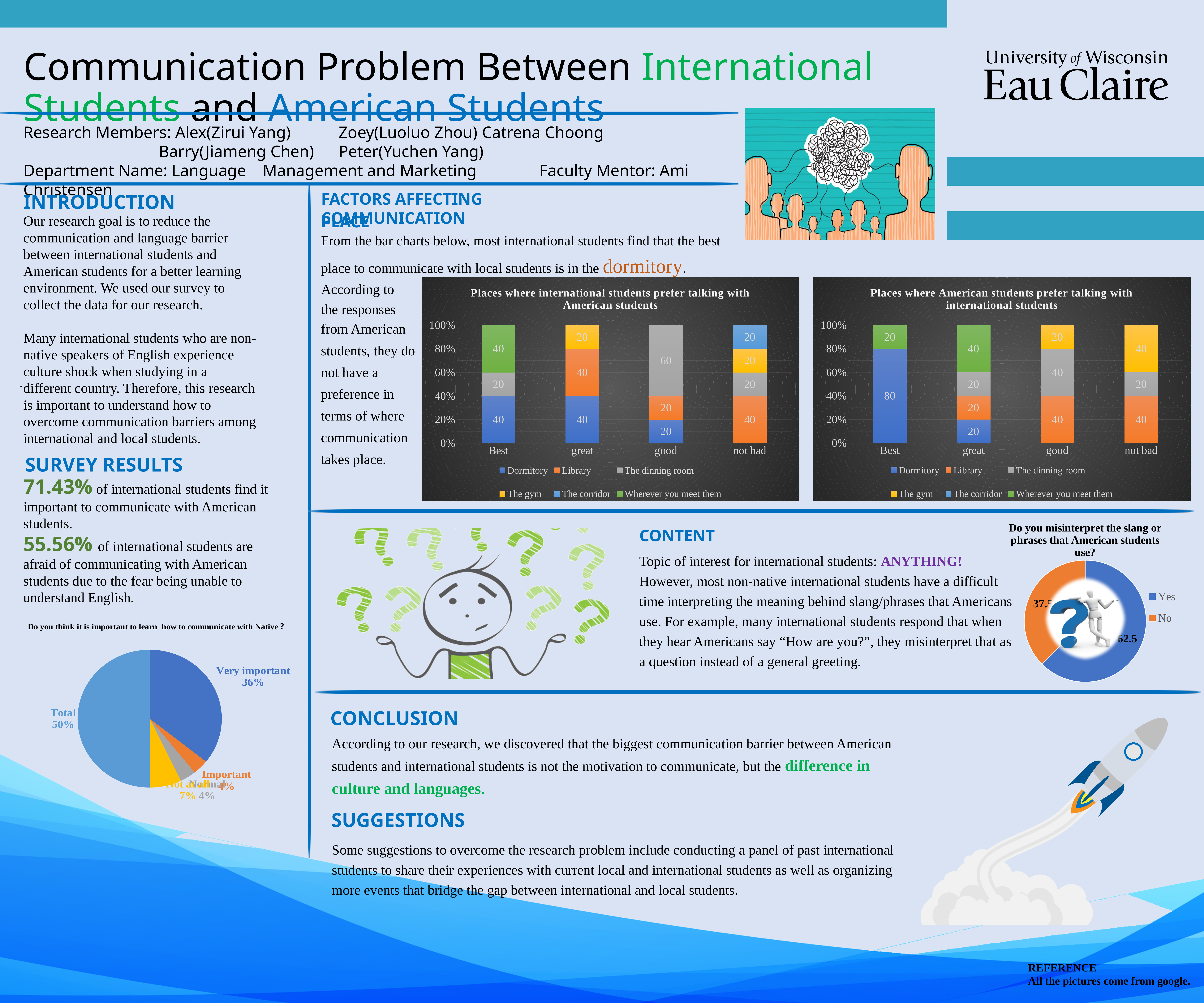
In the pie chart 'Do you think it is important to learn how to communicate with Native?', what share is labelled 'Very important'? 36% In the chart 'Places where international students prefer talking with American students', what is the value for Dormitory in the 'Best' category? 40 In the pie chart 'Do you misinterpret the slang or phrases that American students use?', what is the value for Yes? 62.5 In the chart 'Places where international students prefer talking with American students', what is the difference between The dinning room and Library in the 'good' category? 40 In the chart 'Places where American students prefer talking with international students', which is larger in the 'good' category: Library or The gym? Library In the chart 'Places where international students prefer talking with American students', what is the value for The dinning room in the 'good' category? 60 In the chart 'Places where American students prefer talking with international students', what is the value for Wherever you meet them in the 'great' category? 40 In the chart 'Places where American students prefer talking with international students', what is the value for Dormitory in the 'Best' category? 80 How many categories are shown on the x axis of the chart 'Places where American students prefer talking with international students'? 4 What kind of chart is 'Places where international students prefer talking with American students'? Stacked bar chart How many series does the legend list in the chart 'Places where international students prefer talking with American students'? 6 In the pie chart 'Do you misinterpret the slang or phrases that American students use?', which slice is larger: Yes or No? Yes